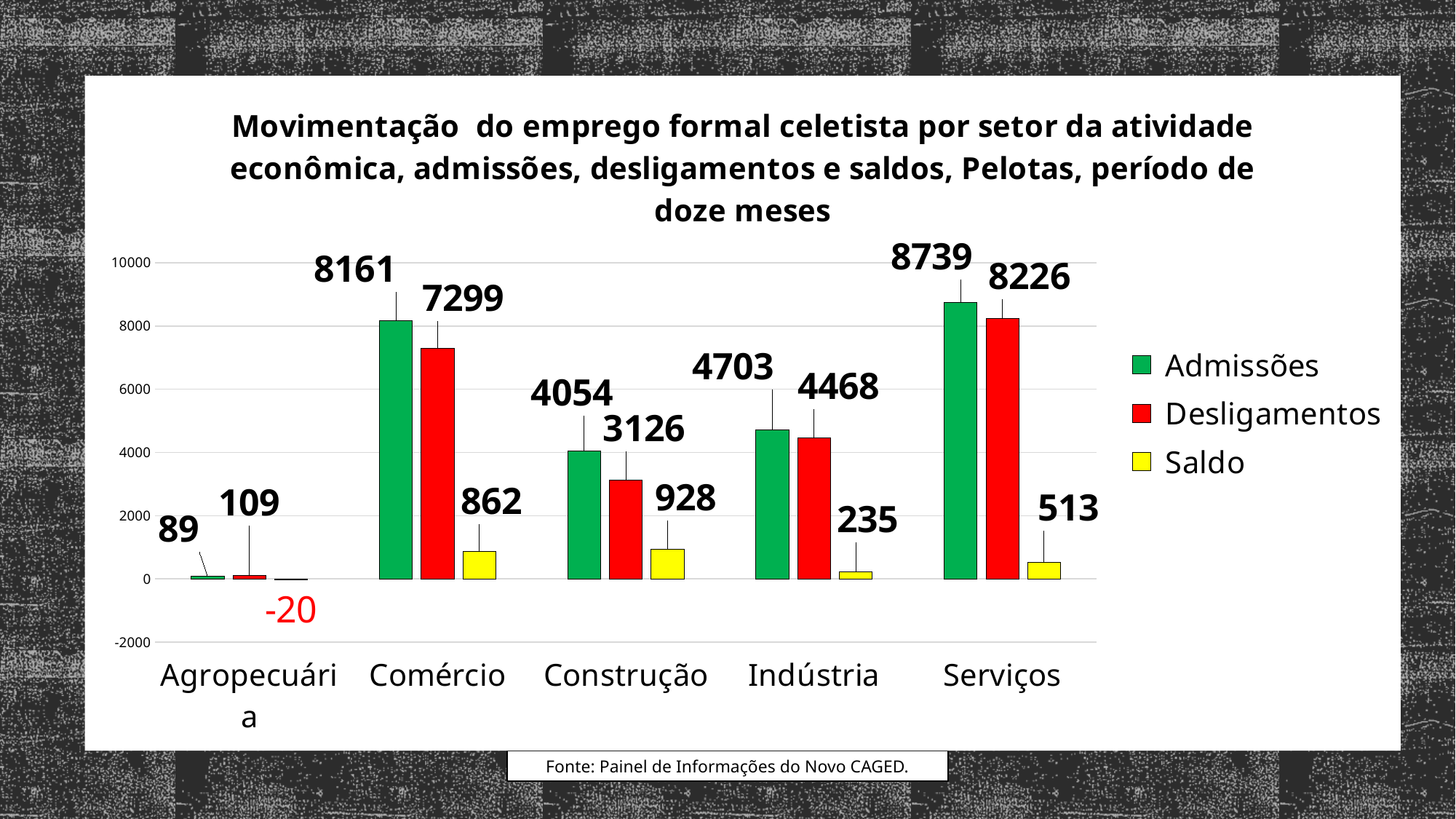
How many series does the legend list? 3 What is the Admissões value for Comércio? 8161 Which sector has the lowest Desligamentos value? Agropecuária Which is larger for Indústria: Admissões or Desligamentos? Admissões What kind of chart is shown on the slide? bar chart What is the difference between Admissões and Desligamentos for Construção? 928 What colour represents the Saldo series? yellow How many sectors are shown on the x axis? 5 Is the Saldo value for Comércio greater or less than 2000? less Which sector has the highest Admissões value? Serviços What is the Saldo value for Agropecuária? -20 What is the Desligamentos value for Serviços? 8226